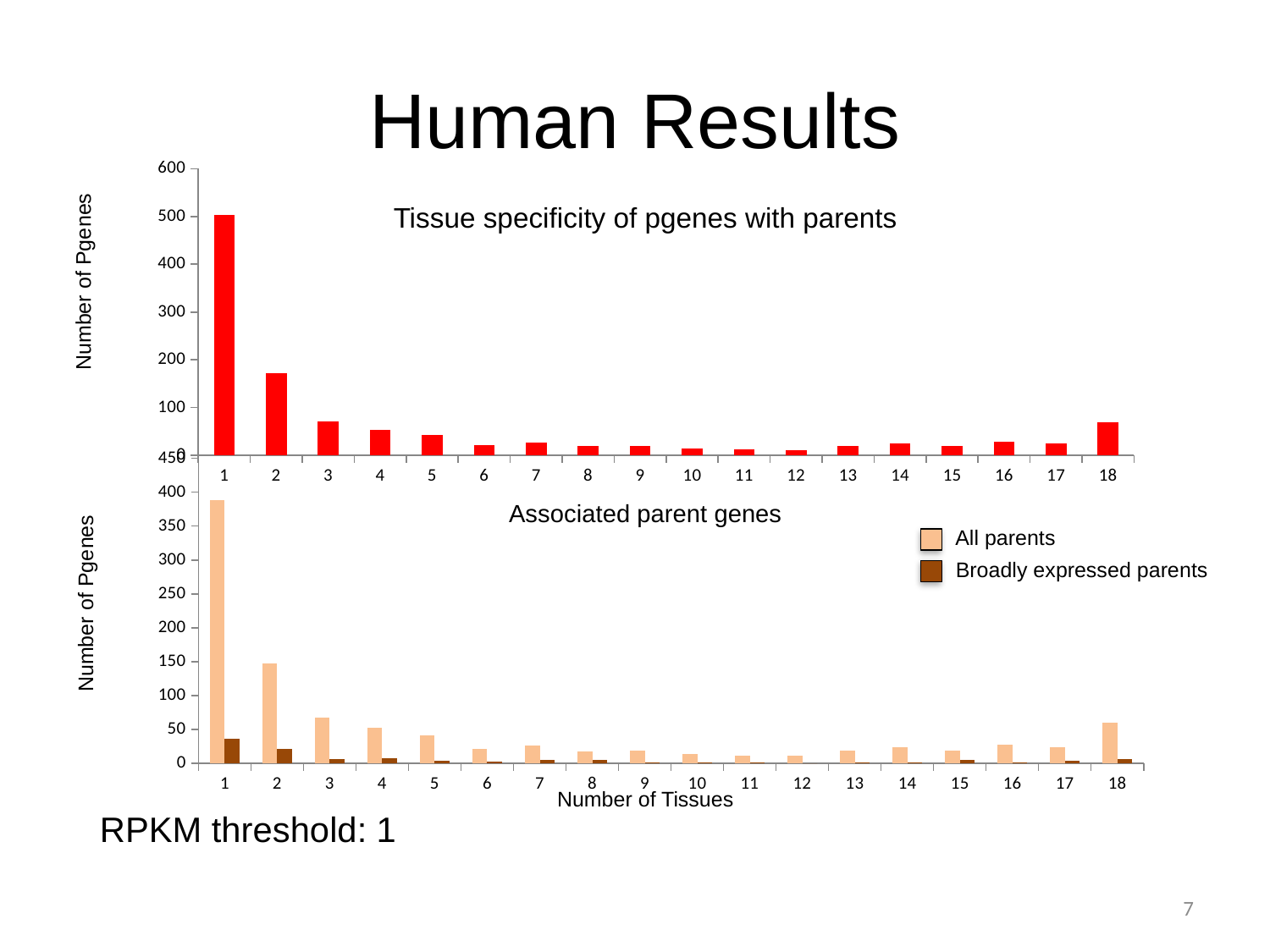
In the top chart, 'Tissue specificity of pgenes with parents', is the value for 18 tissues greater or less than 100? less How many series does the legend of the bottom chart, 'Associated parent genes', list? 2 In the bottom chart, 'Associated parent genes', which series has the larger value for 1 tissue: 'All parents' or 'Broadly expressed parents'? All parents How many number-of-tissues categories are shown on the x axis of the top chart, 'Tissue specificity of pgenes with parents'? 18 What kind of chart is the bottom chart, 'Associated parent genes'? bar chart In the top chart, 'Tissue specificity of pgenes with parents', do the values rise or fall from 1 tissue to 12 tissues? fall In the bottom chart, 'Associated parent genes', is the 'All parents' value for 1 tissue greater or less than 350? greater In the bottom chart, 'Associated parent genes', is the 'Broadly expressed parents' value for 1 tissue greater or less than 50? less In the top chart, 'Tissue specificity of pgenes with parents', which number of tissues has the highest number of pgenes? 1 In the top chart, 'Tissue specificity of pgenes with parents', which is larger: the value for 2 tissues or the value for 3 tissues? 2 tissues